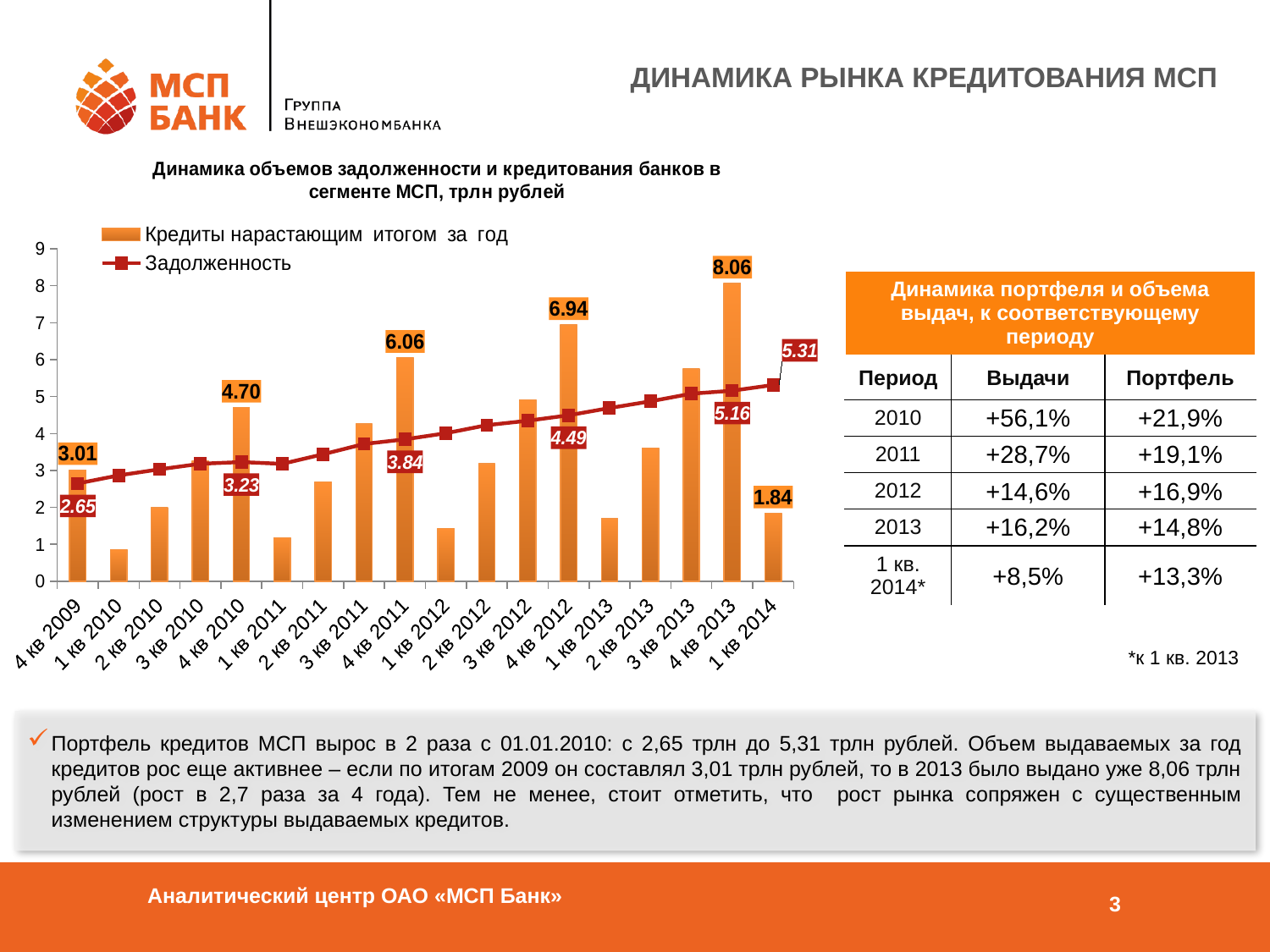
How many quarters are shown on the x axis? 18 Which is larger: the bar for 4 кв 2012 or the bar for 4 кв 2010? 4 кв 2012 What is the 'Задолженность' value for 4 кв 2009? 2.65 By how much did 'Задолженность' increase from 4 кв 2009 to 1 кв 2014? 2.66 What is the value of the bar for 4 кв 2011? 6.06 Which quarter has the highest 'Кредиты нарастающим итогом за год' bar? 4 кв 2013 Which quarter has the lowest 'Кредиты нарастающим итогом за год' bar? 1 кв 2010 Does the 'Задолженность' line rise or fall from 4 кв 2009 to 1 кв 2014? rises What is the 'Задолженность' value for 1 кв 2014? 5.31 What is the difference between the bar values for 4 кв 2013 and 4 кв 2009? 5.05 What is the value of the 'Кредиты нарастающим итогом за год' bar for 4 кв 2013? 8.06 Is the bar value for 3 кв 2013 greater or less than 5? greater